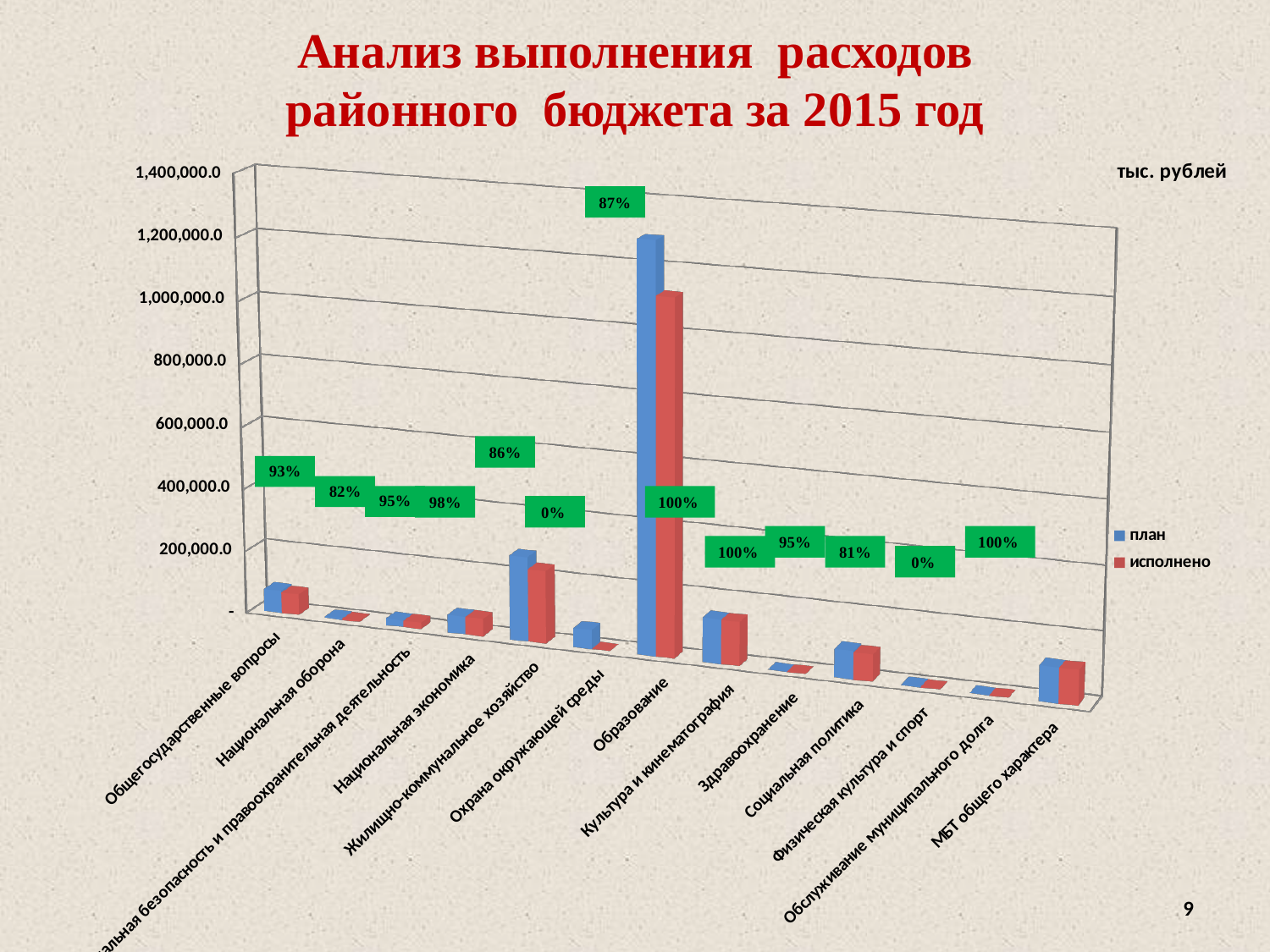
What execution percentage is labelled for Общегосударственные вопросы? 93% What execution percentage is labelled for Национальная оборона? 82% In what units are the values on the chart expressed, according to the label in the top right? тыс. рублей Is the план value for Образование greater or less than 800,000.0? greater What execution percentage is labelled for Физическая культура и спорт? 81% How many expenditure categories are shown on the x axis? 13 What are the two series named in the legend? план, исполнено Which category has the highest план value? Образование What kind of chart is shown on the slide? bar chart How many series does the legend list? 2 What execution percentage is labelled above Образование? 87% Which has the larger план value: Образование or Жилищно-коммунальное хозяйство? Образование